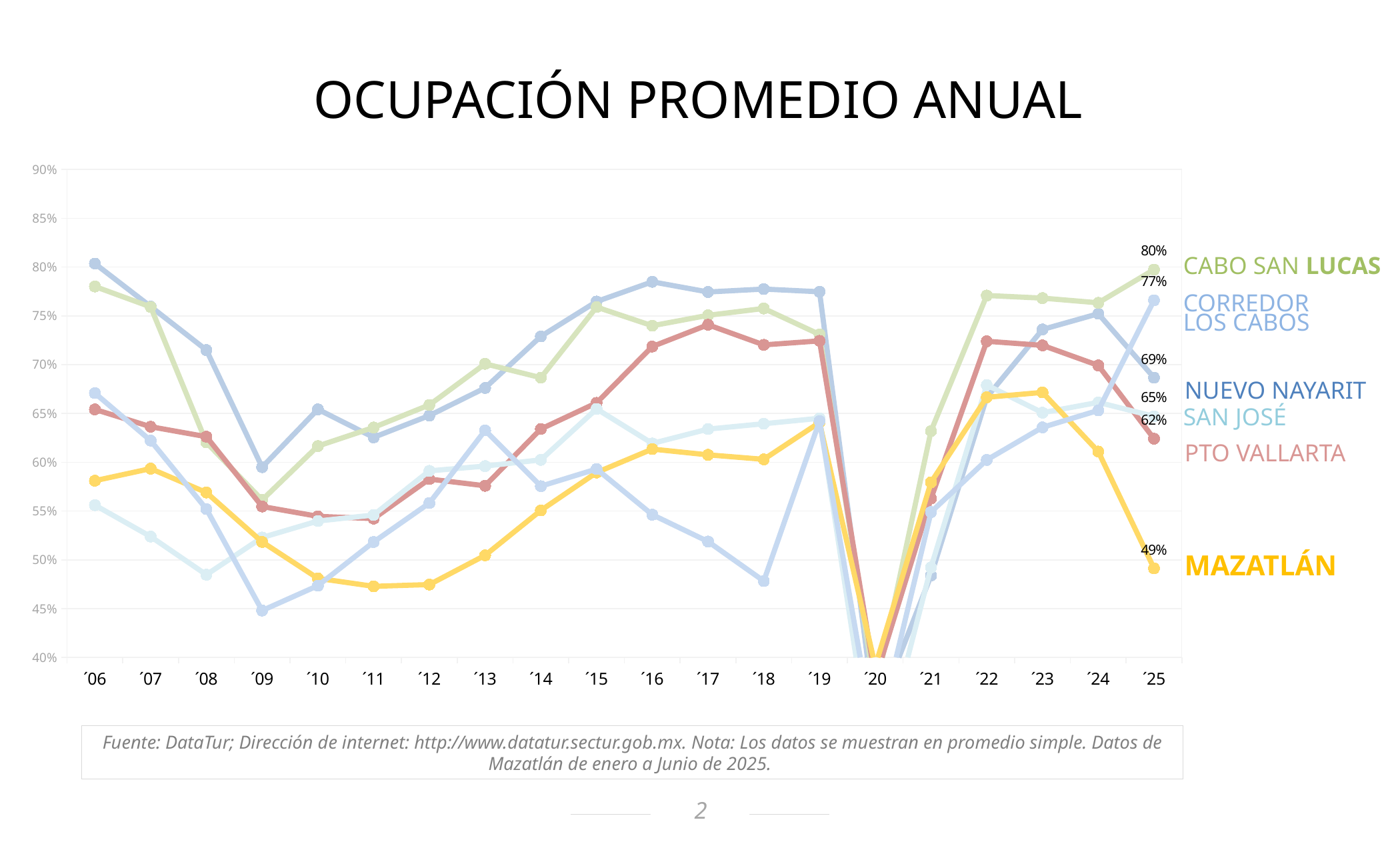
How many years are shown on the x axis? 20 What is the occupancy value for CABO SAN LUCAS in '25? 80% How many destinations (series) are plotted on the chart? 6 What kind of chart is shown on the slide? line chart What is the difference between the '25 values for CABO SAN LUCAS and MAZATLÁN? 31 percentage points Does the MAZATLÁN line rise or fall from '23 to '25? fall In '25, which is higher: NUEVO NAYARIT or SAN JOSÉ? NUEVO NAYARIT Is the value for MAZATLÁN in '09 greater or less than 55%? less Which destination has the highest occupancy in '25? CABO SAN LUCAS What is the occupancy value for PTO VALLARTA in '25? 62% What is the occupancy value for MAZATLÁN in '25? 49% Which destination has the lowest occupancy in '25? MAZATLÁN